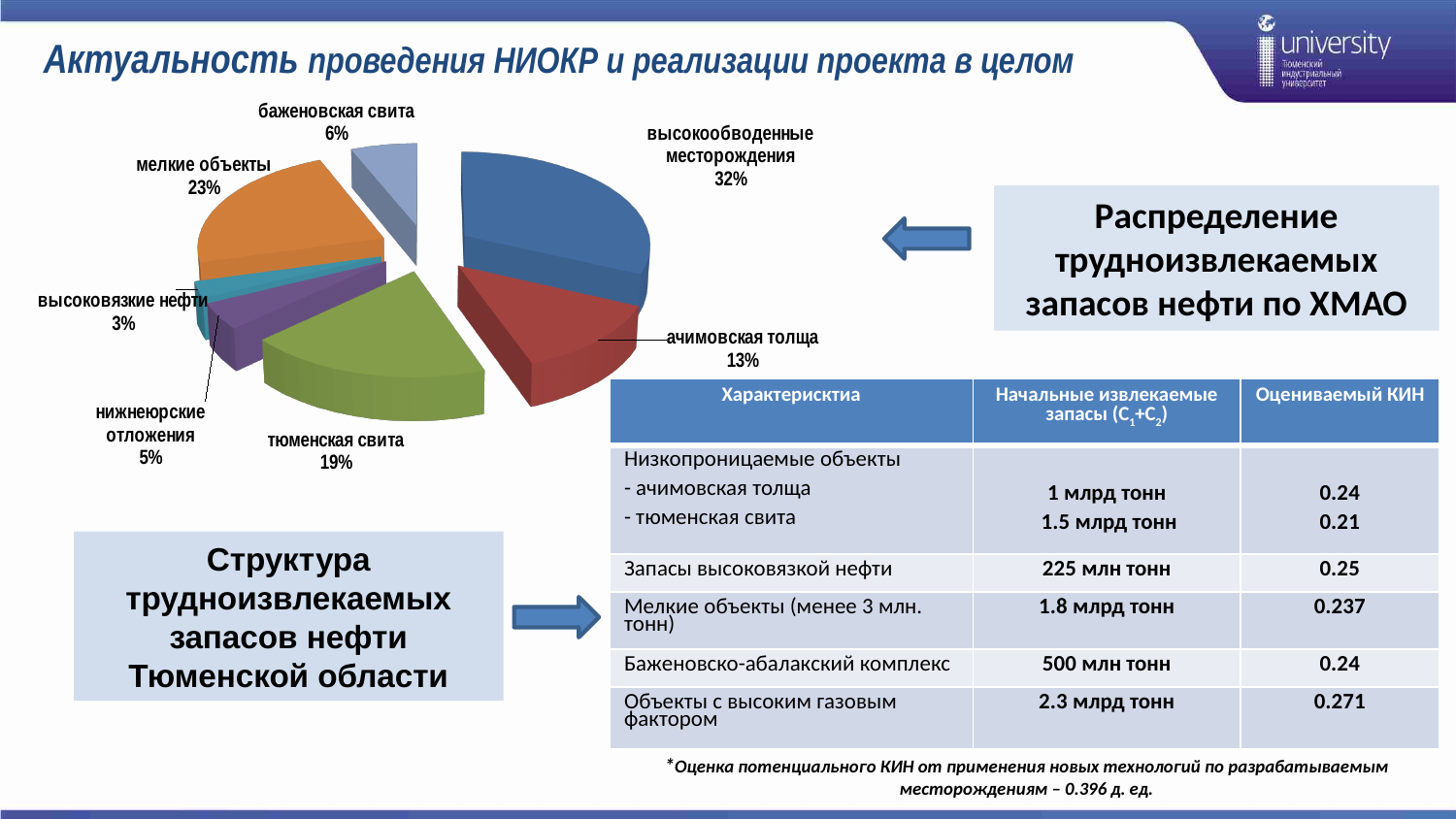
According to the text box with the arrow pointing to the pie chart, what does the pie chart show? Распределение трудноизвлекаемых запасов нефти по ХМАО Which category has the largest slice in the pie chart? высокообводненные месторождения What share of the pie chart is labelled "тюменская свита"? 19% Which slice is larger: "баженовская свита" or "ачимовская толща"? ачимовская толща What share of the pie chart is labelled "нижнеюрские отложения"? 5% Which category has the smallest slice in the pie chart? высоковязкие нефти What type of chart is shown on the slide? pie chart What is the difference in percentage points between the "мелкие объекты" slice and the "тюменская свита" slice? 4 What share of the pie chart is labelled "высокообводненные месторождения"? 32% What share of the pie chart is labelled "мелкие объекты"? 23% What share of the pie chart is labelled "ачимовская толща"? 13% How many slices does the pie chart have? 7